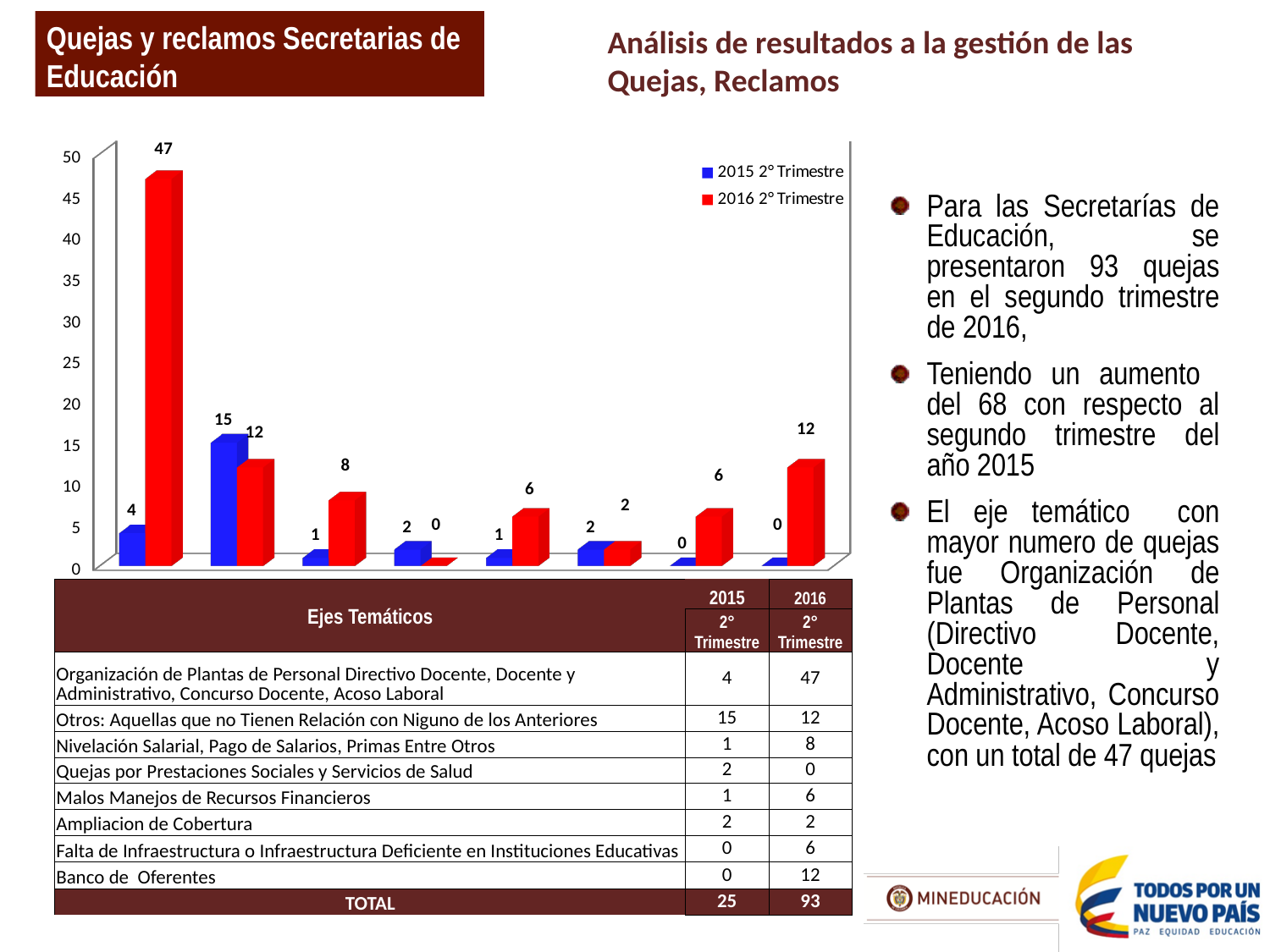
Which category has the highest 2016 2° Trimestre value? Organización de Plantas de Personal Directivo Docente, Docente y Administrativo, Concurso Docente, Acoso Laboral How many series does the chart legend list? 2 How many categories (ejes temáticos) are plotted in the chart? 8 What is the 2015 2° Trimestre value for Otros: Aquellas que no Tienen Relación con Niguno de los Anteriores? 15 What is the difference between the 2016 and 2015 2° Trimestre values for Nivelación Salarial, Pago de Salarios, Primas Entre Otros? 7 What is the 2016 2° Trimestre value for Organización de Plantas de Personal Directivo Docente, Docente y Administrativo, Concurso Docente, Acoso Laboral? 47 What type of chart is shown on the slide? bar chart What are the two series named in the chart legend? 2015 2° Trimestre and 2016 2° Trimestre What is the total of the 2016 2° Trimestre values across all categories? 93 What is the 2016 2° Trimestre value for Banco de Oferentes? 12 Which is larger for Otros: Aquellas que no Tienen Relación con Niguno de los Anteriores, the 2015 2° Trimestre value or the 2016 2° Trimestre value? 2015 2° Trimestre Which colour represents the 2016 2° Trimestre series in the chart? red